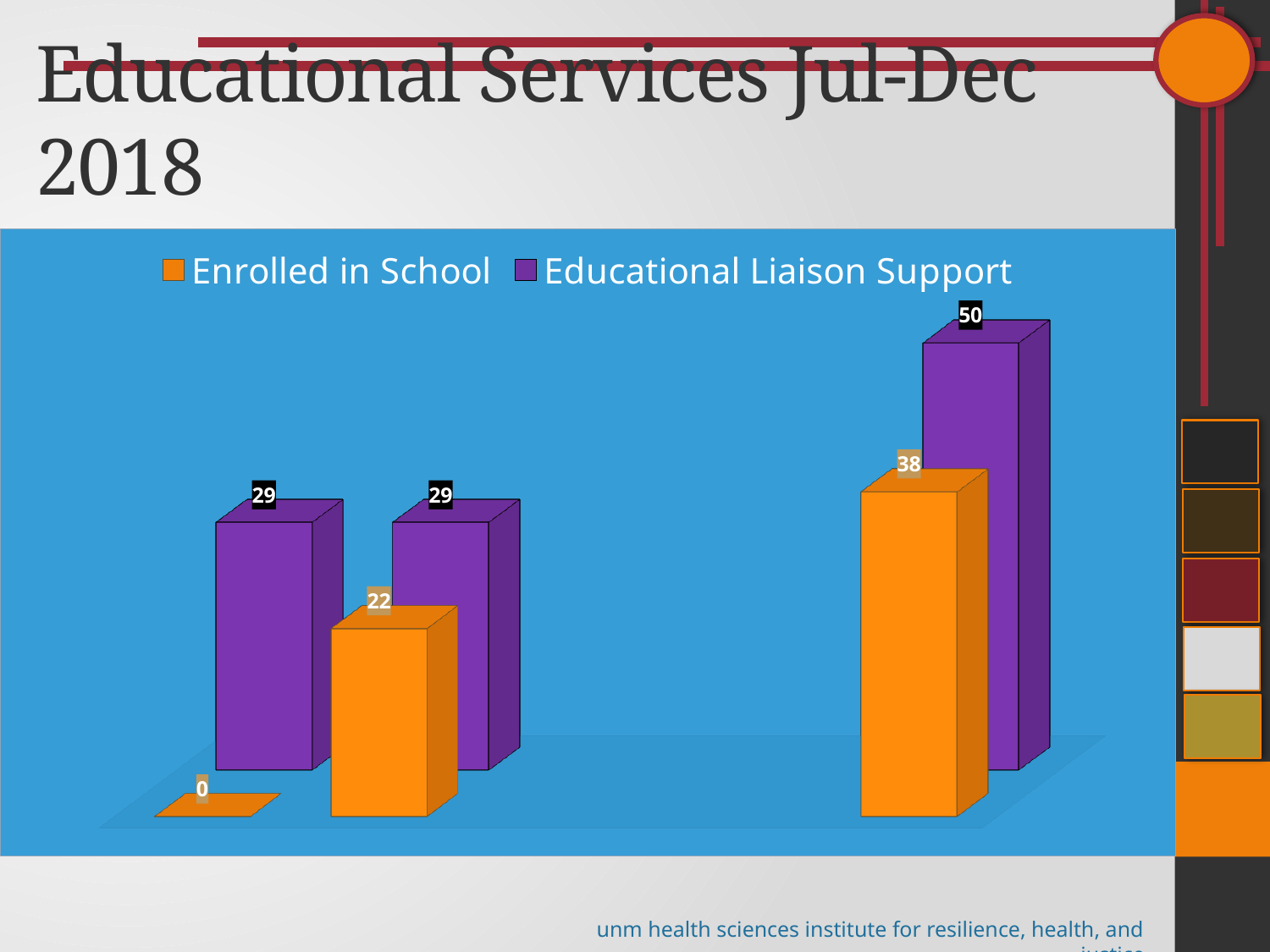
In the middle group of bars, what is the difference between Educational Liaison Support and Enrolled in School? 7 What colour represents Enrolled in School in the chart? orange What is the Enrolled in School value in the middle group of bars? 22 What is the highest value shown for Enrolled in School? 38 What is the highest value shown for Educational Liaison Support? 50 What is the Enrolled in School value in the leftmost group of bars? 0 What is the lowest value shown for Enrolled in School? 0 In the rightmost group of bars, which series has the larger value, Enrolled in School or Educational Liaison Support? Educational Liaison Support How many groups of bars are plotted in the chart? 3 What kind of chart is shown on the slide? bar chart How many series does the chart legend list? 2 In the rightmost group of bars, what is the difference between Educational Liaison Support and Enrolled in School? 12